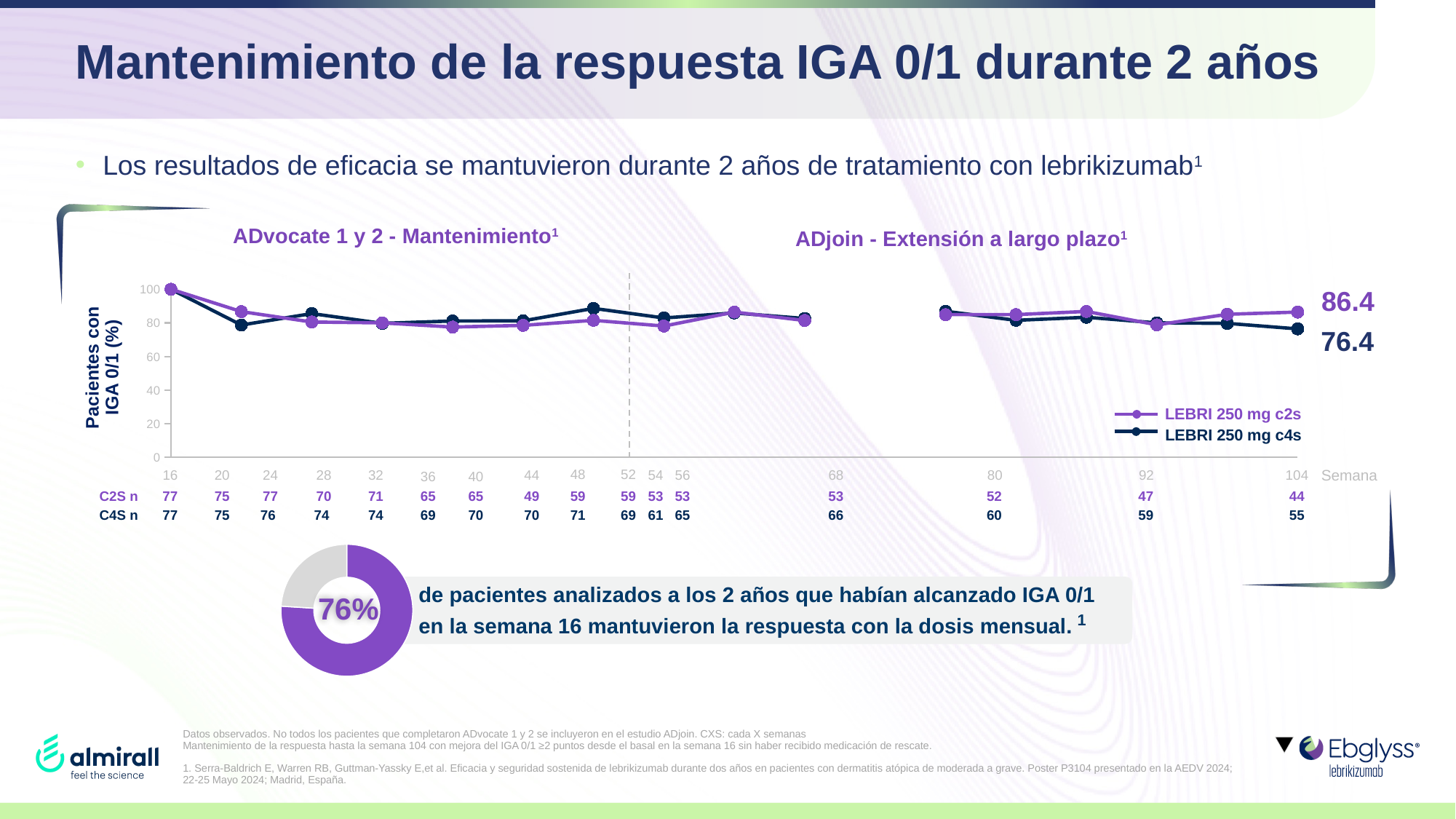
In the line chart, what is the difference between the LEBRI 250 mg c2s and LEBRI 250 mg c4s values at week 104? 10 What kind of chart is the main chart showing patients with IGA 0/1 over weeks? line chart In the line chart, what is the value for LEBRI 250 mg c4s at week 104? 76.4 In the line chart, what is the value for both series at week 16? 100 What percentage does the donut chart at the bottom of the slide show? 76% In the line chart, what is the C2S n value shown under week 104? 44 In the line chart, which series has the higher value at week 104, LEBRI 250 mg c2s or LEBRI 250 mg c4s? LEBRI 250 mg c2s How many series does the legend of the line chart list? 2 In the line chart, what is the value for LEBRI 250 mg c2s at week 104? 86.4 In the line chart, is the value for LEBRI 250 mg c2s at week 68 greater or less than 60? greater In the line chart legend, which colour represents LEBRI 250 mg c2s? purple In the line chart, do the values rise or fall between week 16 and week 20? fall